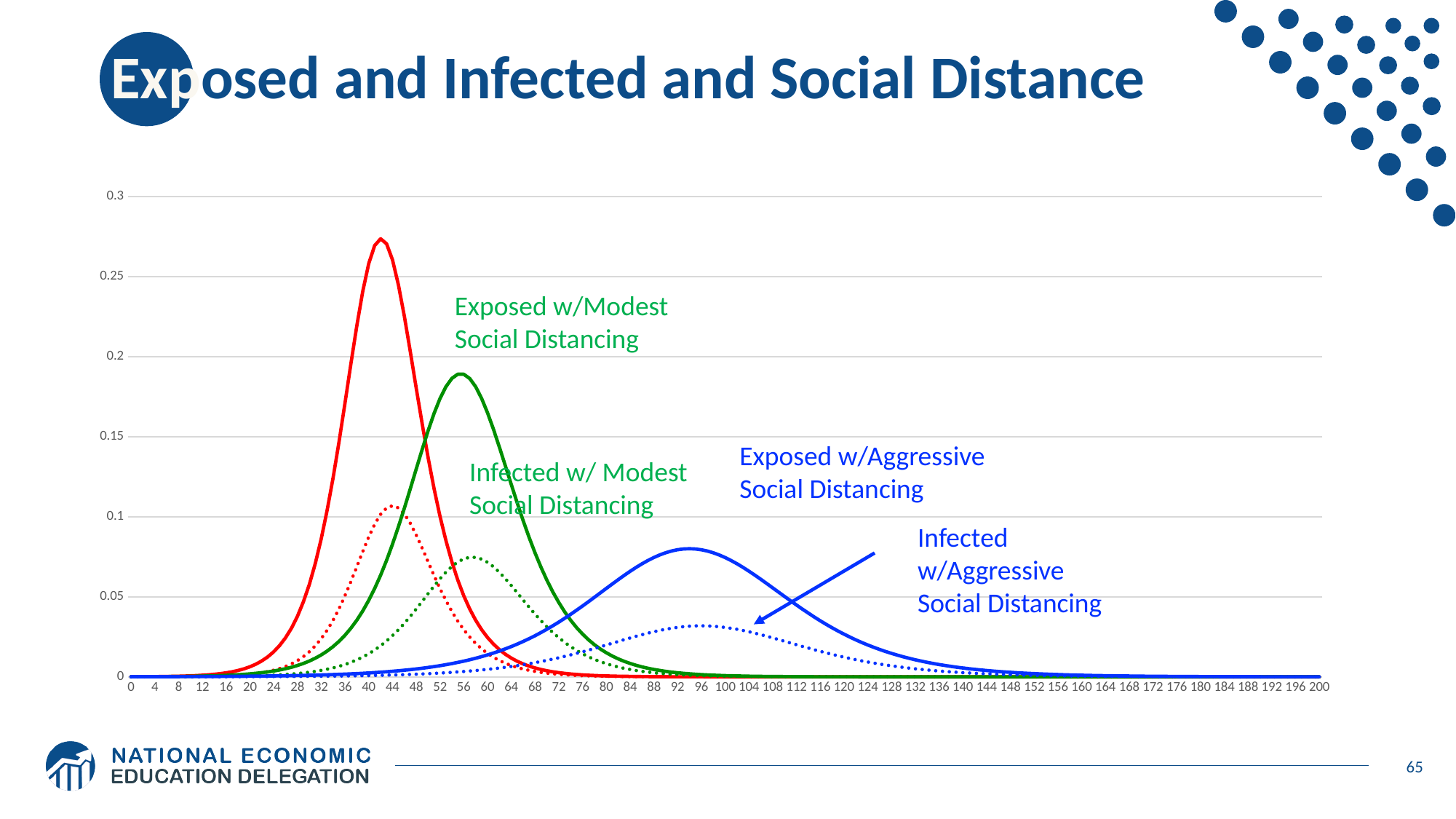
Is the peak value of the Exposed w/Modest Social Distancing line greater or less than 0.15? greater Is the peak value of the Exposed w/Aggressive Social Distancing line greater or less than 0.1? less What is the title of the chart slide? Exposed and Infected and Social Distance Is the peak value of the Exposed w/Modest Social Distancing line greater or less than 0.2? less What kind of chart is shown on the slide? line chart Which colour is used for the Aggressive Social Distancing lines? blue How many lines are plotted on the chart? 6 Which line reaches a higher peak: Infected w/ Modest Social Distancing or Infected w/Aggressive Social Distancing? Infected w/ Modest Social Distancing Which line reaches a higher peak: Exposed w/Modest Social Distancing or Exposed w/Aggressive Social Distancing? Exposed w/Modest Social Distancing What is the highest value shown on the y axis? 0.3